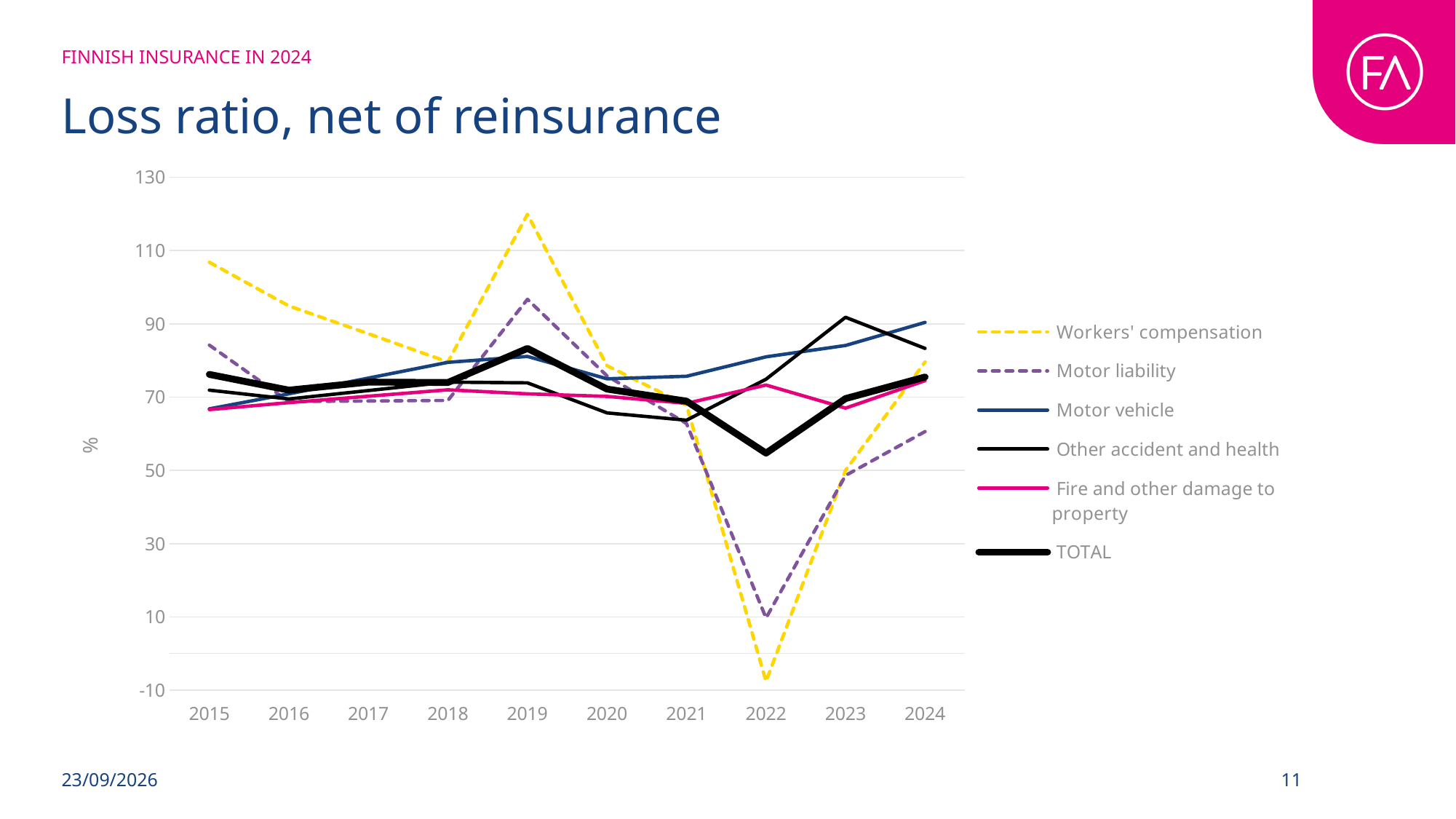
In 2015, which is larger: Workers' compensation or Motor liability? Workers' compensation Is the value for TOTAL in 2022 greater or less than 70? less Which series has the highest value in 2019? Workers' compensation How many series does the legend list? 6 Is the value for Workers' compensation in 2022 greater or less than 10? less Which series has the lowest value in 2022? Workers' compensation Which series has the highest value in 2023? Other accident and health How many years are shown on the x axis? 10 Is the value for Workers' compensation in 2019 greater or less than 110? greater Does the Workers' compensation series rise or fall from 2015 to 2018? fall What kind of chart is shown on the slide? line chart In which year does the TOTAL series reach its lowest value? 2022